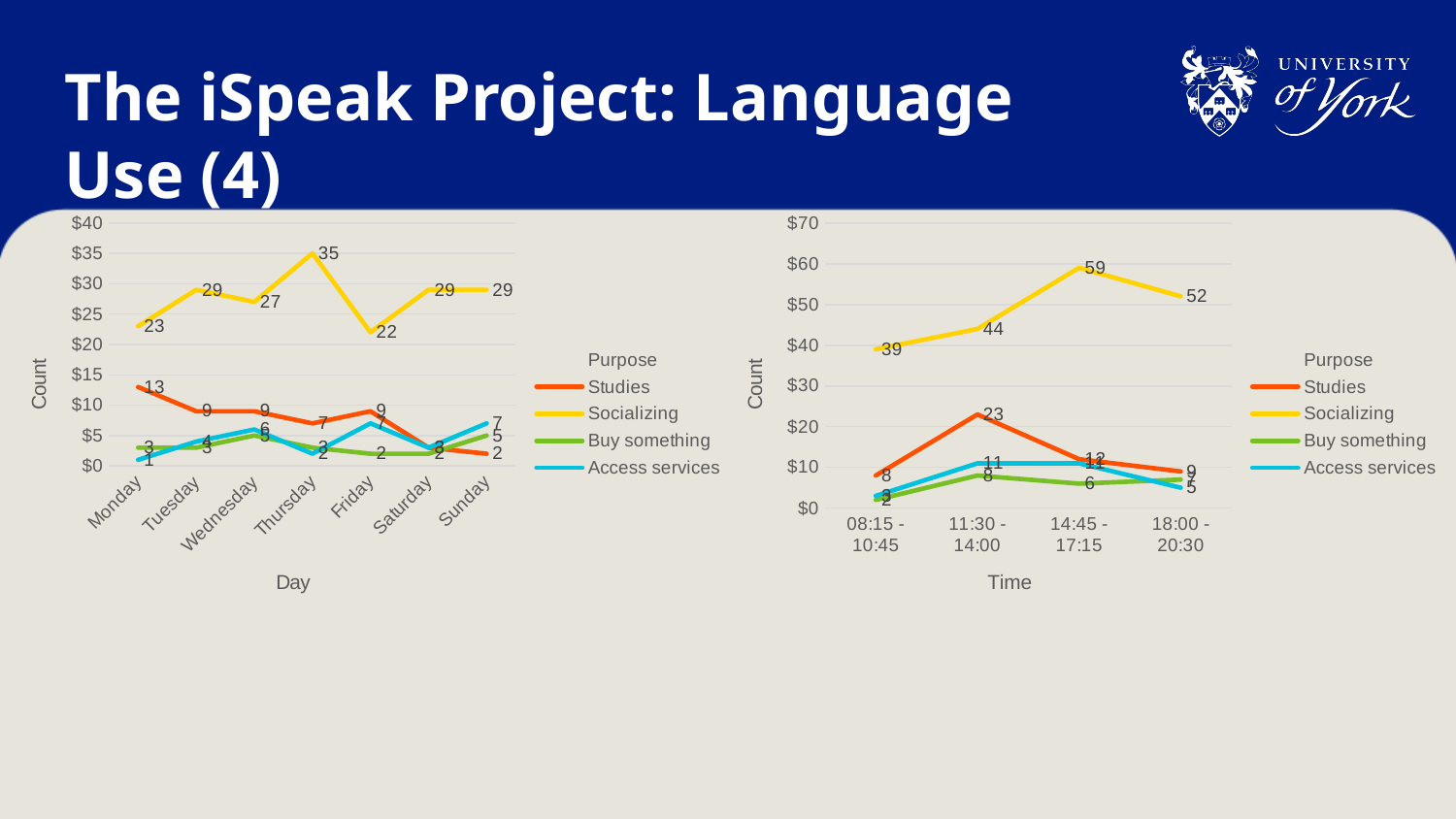
In the left chart (by Day), on which day is Socializing highest? Thursday In the left chart (by Day), what is the Studies value on Monday? 13 In the left chart (by Day), how many days are shown on the x axis? 7 In the right chart (by Time), what is the Studies value for 11:30 - 14:00? 23 In the right chart (by Time), in which time slot is Socializing lowest? 08:15 - 10:45 In the left chart (by Day), what is the Socializing value on Thursday? 35 What kind of chart is the left chart (by Day)? Line chart In the left chart (by Day), what is the difference between the Socializing values on Thursday and Friday? 13 In the right chart (by Time), which is larger, Socializing at 11:30 - 14:00 or Socializing at 18:00 - 20:30? Socializing at 18:00 - 20:30 How many series does the legend of the right chart (by Time) list? 4 In the right chart (by Time), what is the Socializing value for 14:45 - 17:15? 59 In the left chart (by Day), on which day is Socializing lowest? Friday